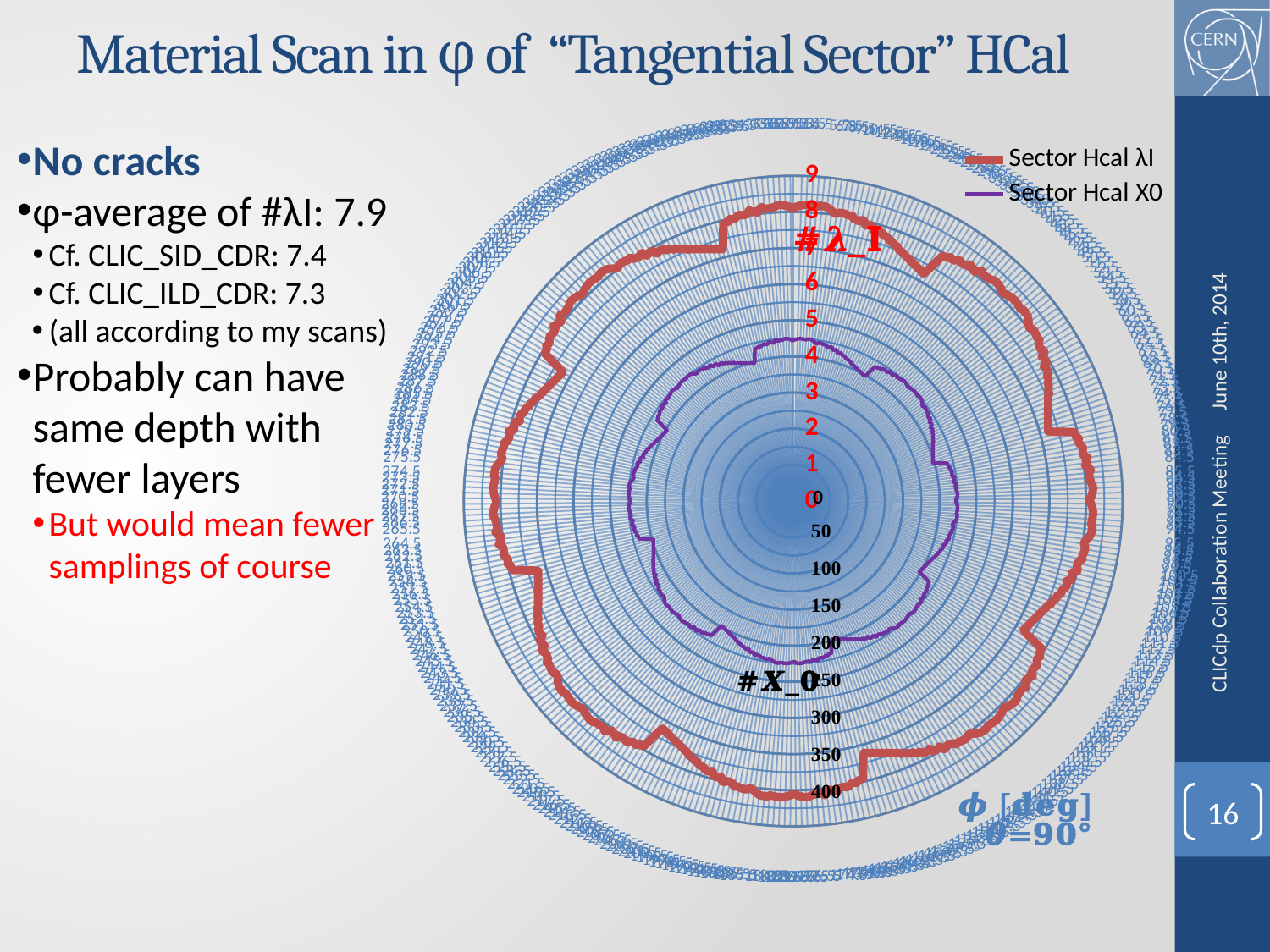
Is the Sector Hcal λI curve greater or less than 5 on the red radial axis at every angle? greater Is the Sector Hcal λI curve greater or less than 9 on the red radial axis at every angle? less How many series does the chart legend list? 2 What kind of chart is shown on the slide? Radar chart What are the two series named in the chart legend? Sector Hcal λI and Sector Hcal X0 Which colour is used for the Sector Hcal λI series in the chart? Red Is the Sector Hcal λI curve greater or less than 6 on the red radial axis at every angle? greater